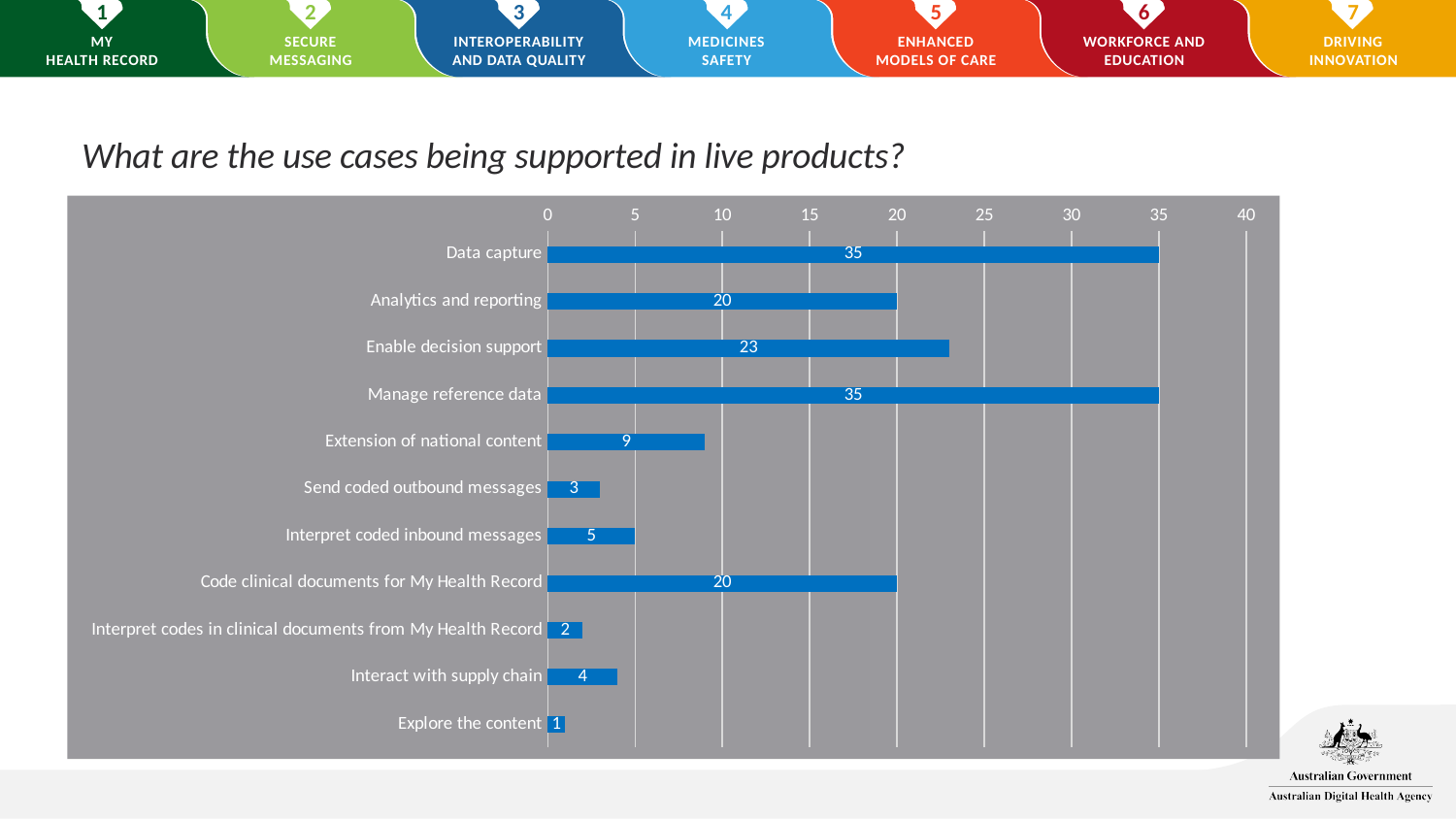
Is the value for Code clinical documents for My Health Record greater or less than 15? greater Which category has the lowest value? Explore the content What is the difference between the values for Enable decision support and Analytics and reporting? 3 What is the title of the slide above the chart? What are the use cases being supported in live products? What is the value for Extension of national content? 9 What is the value for Interpret codes in clinical documents from My Health Record? 2 What kind of chart is shown on the slide? Bar chart What is the value for Enable decision support? 23 What is the value for Interact with supply chain? 4 Which is larger, the value for Interpret coded inbound messages or the value for Send coded outbound messages? Interpret coded inbound messages How many categories are shown in the chart? 11 What is the value for Data capture? 35